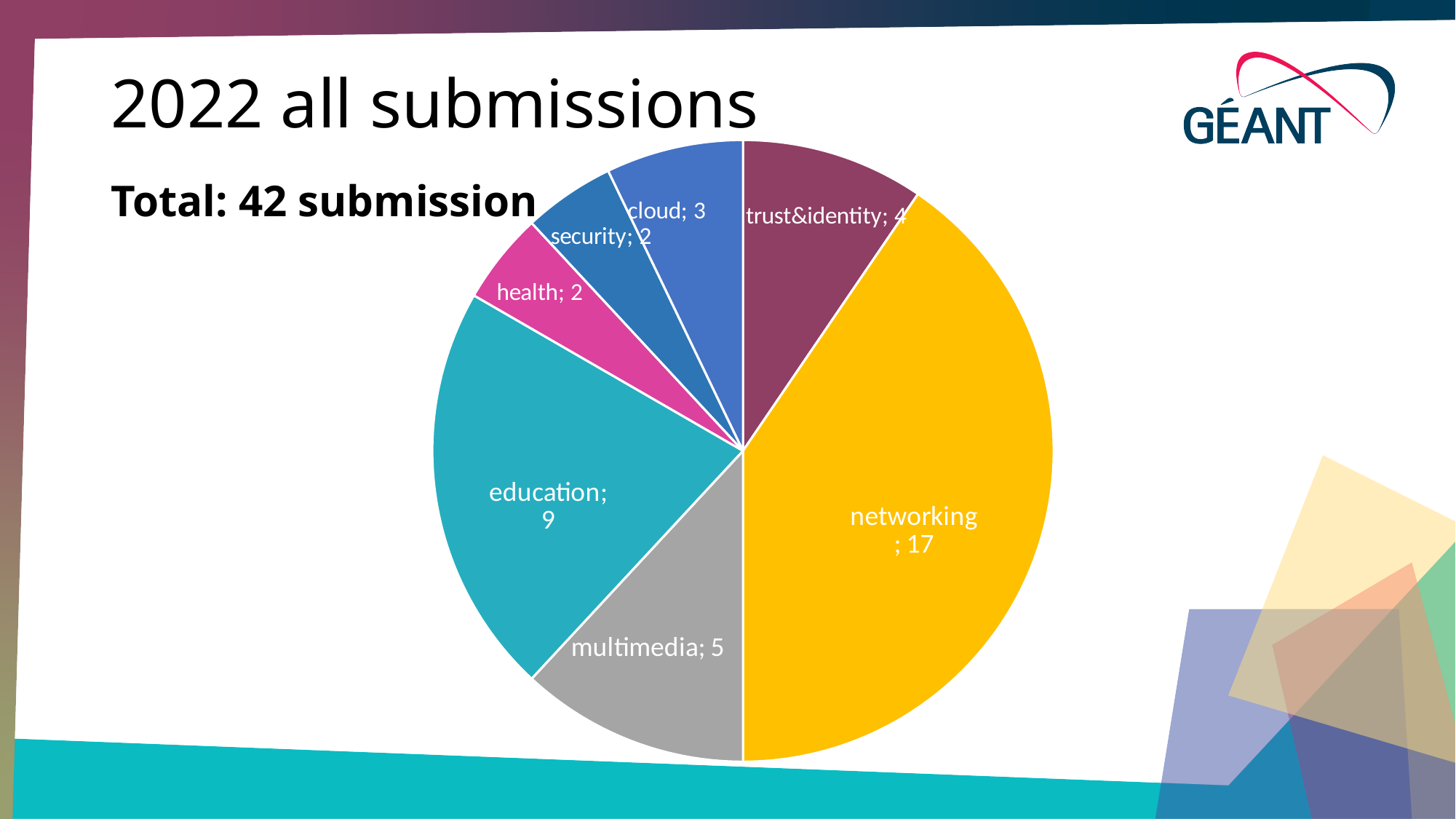
How many submissions are in the networking category? 17 Which two categories share the smallest number of submissions? health and security What kind of chart is shown on the slide? pie chart How many submissions are in the education category? 9 How many submissions are in the multimedia category? 5 Which category has the largest number of submissions? networking What is the difference between the networking and education submission counts? 8 How many submissions are in the cloud category? 3 Which has more submissions, multimedia or trust&identity? multimedia How many categories does the pie chart show? 7 How many submissions are in the trust&identity category? 4 What is the total number of submissions stated on the slide? 42